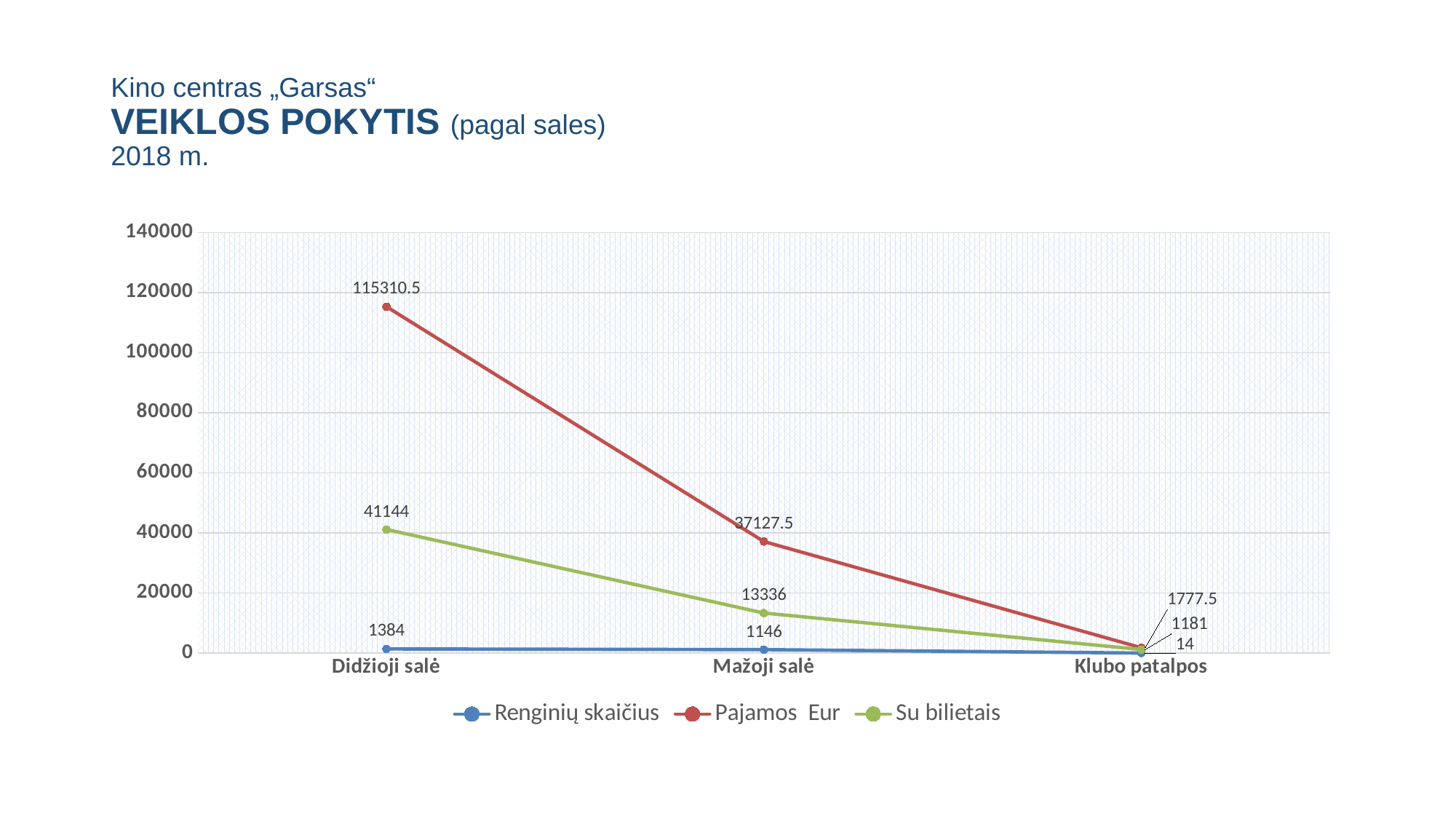
What kind of chart is shown on the slide? line chart What is the difference between Su bilietais for Didžioji salė and for Mažoji salė? 27808 How many categories are shown on the x axis? 3 What is the value of Pajamos Eur for Klubo patalpos? 1777.5 Which category has the lowest value for Su bilietais? Klubo patalpos Which category has the highest value for Pajamos Eur? Didžioji salė Which is larger: Pajamos Eur for Mažoji salė or Su bilietais for Didžioji salė? Su bilietais for Didžioji salė What is the value of Renginių skaičius for Didžioji salė? 1384 Do the Pajamos Eur values rise or fall from Didžioji salė to Klubo patalpos? fall How many series does the legend list? 3 What is the value of Pajamos Eur for Didžioji salė? 115310.5 What is the value of Su bilietais for Mažoji salė? 13336